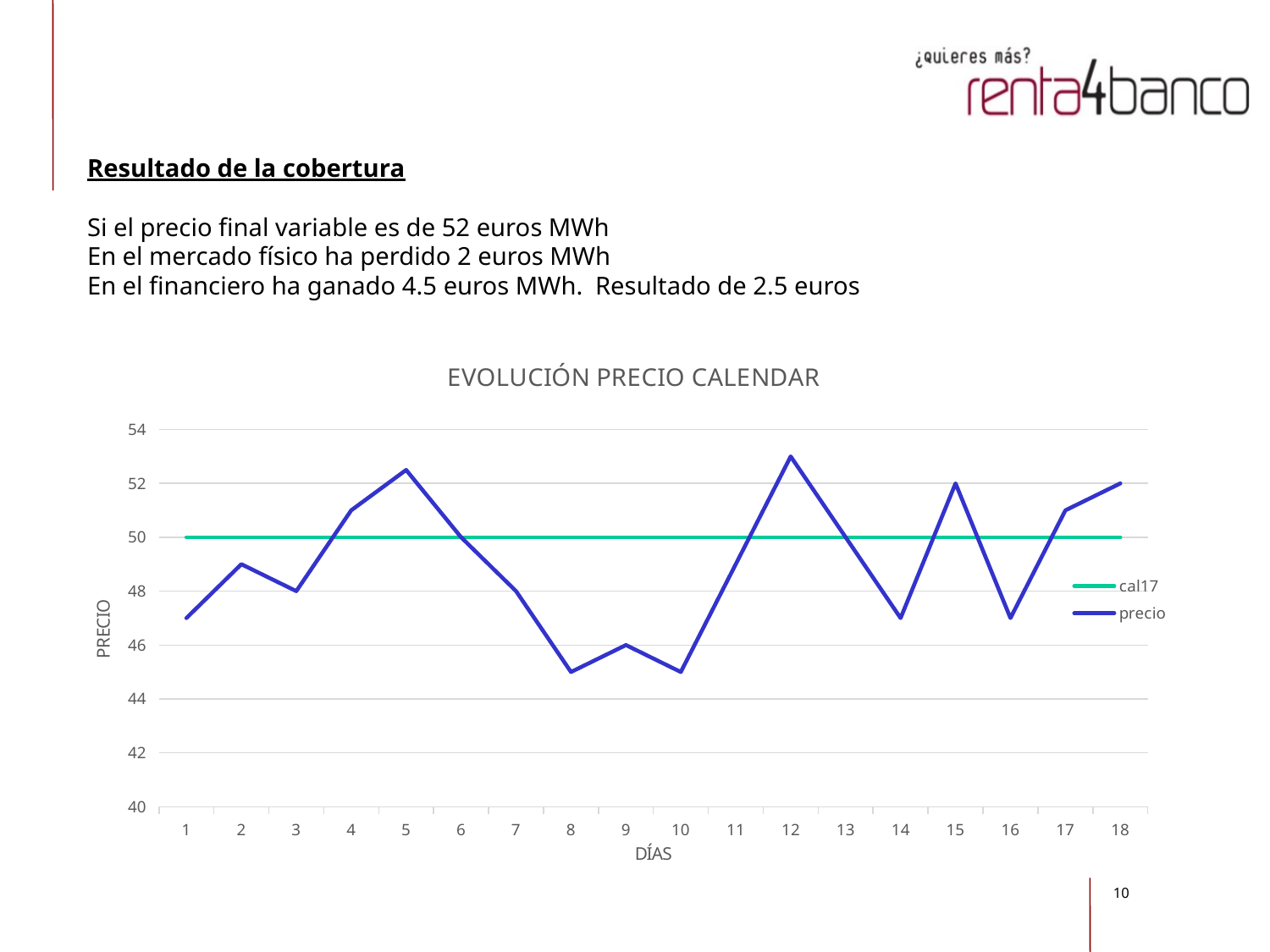
How many series does the legend list? 2 Does precio rise or fall from day 5 to day 8? Fall What is the value of the cal17 series? 50 Is the precio value on day 12 greater or less than 52? greater What is the title of the chart? EVOLUCIÓN PRECIO CALENDAR What kind of chart is shown on the slide? Line chart Is the precio value on day 1 greater or less than 48? less What is the precio value on day 15? 52 How many days are plotted on the x axis? 18 What is the difference between the precio values on day 15 and day 9? 6 On which day does precio reach its highest value? 12 What is the precio value on day 9? 46